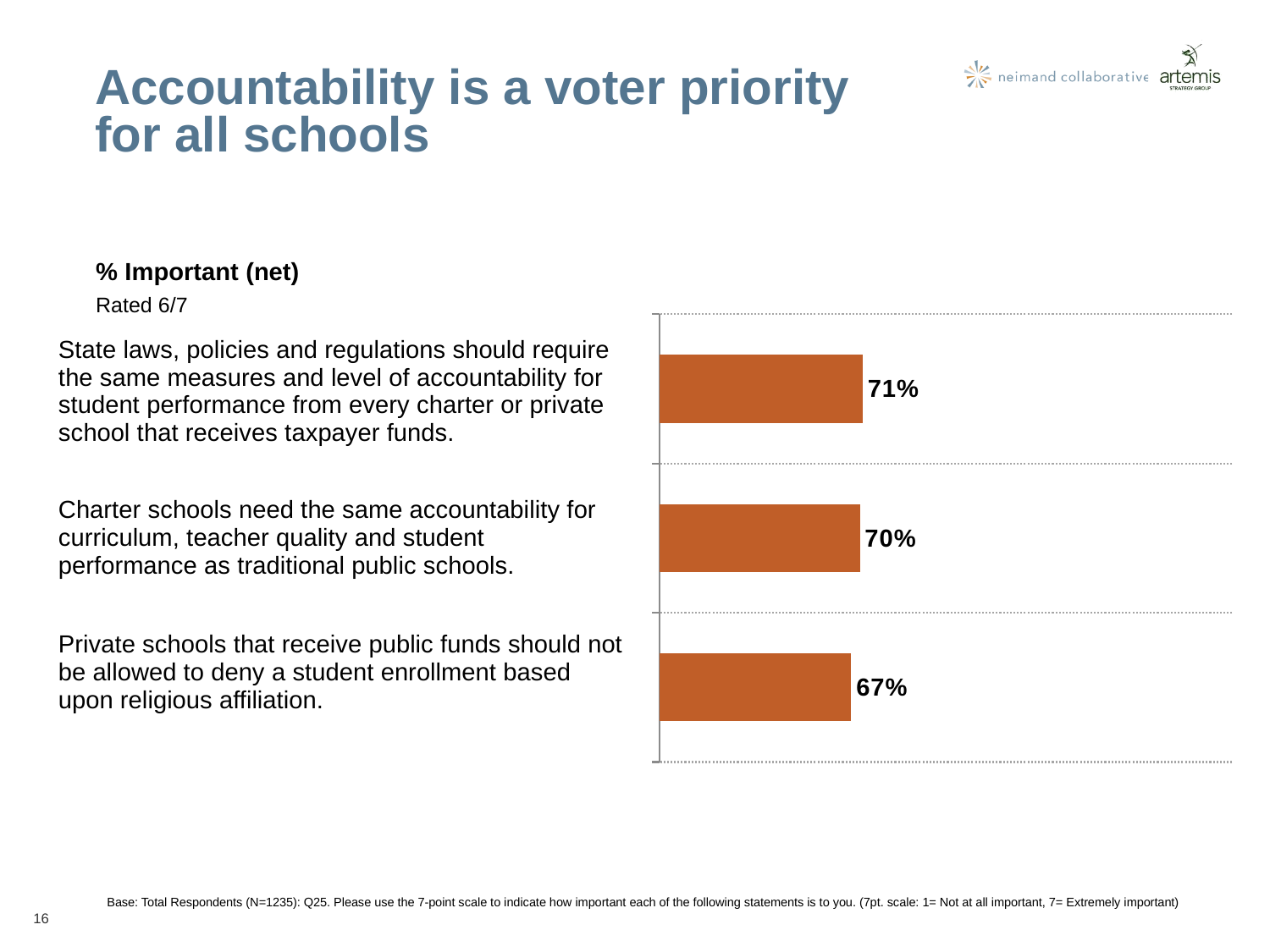
Which statement has the lowest % Important (net)? Private schools that receive public funds should not be allowed to deny a student enrollment based upon religious affiliation. What is the base size of respondents noted for the chart? N=1235 What is the difference in percentage points between the charter schools accountability statement (70%) and the private schools religious affiliation statement (67%)? 3 Which statement has the highest % Important (net)? State laws, policies and regulations should require the same measures and level of accountability for student performance from every charter or private school that receives taxpayer funds. What kind of chart is shown on the slide? Bar chart What percentage rated the statement 'State laws, policies and regulations should require the same measures and level of accountability for student performance from every charter or private school that receives taxpayer funds' as important? 71% What is the difference in percentage points between the highest and lowest % Important (net) values shown? 4 What rating range is counted as 'Important (net)' in the chart? Rated 6/7 What percentage rated the statement 'Charter schools need the same accountability for curriculum, teacher quality and student performance as traditional public schools' as important? 70% What percentage rated the statement 'Private schools that receive public funds should not be allowed to deny a student enrollment based upon religious affiliation' as important? 67% How many statements are plotted in the chart? 3 Which has a higher % Important (net): the state laws accountability statement or the private schools religious affiliation statement? State laws accountability statement (71%)